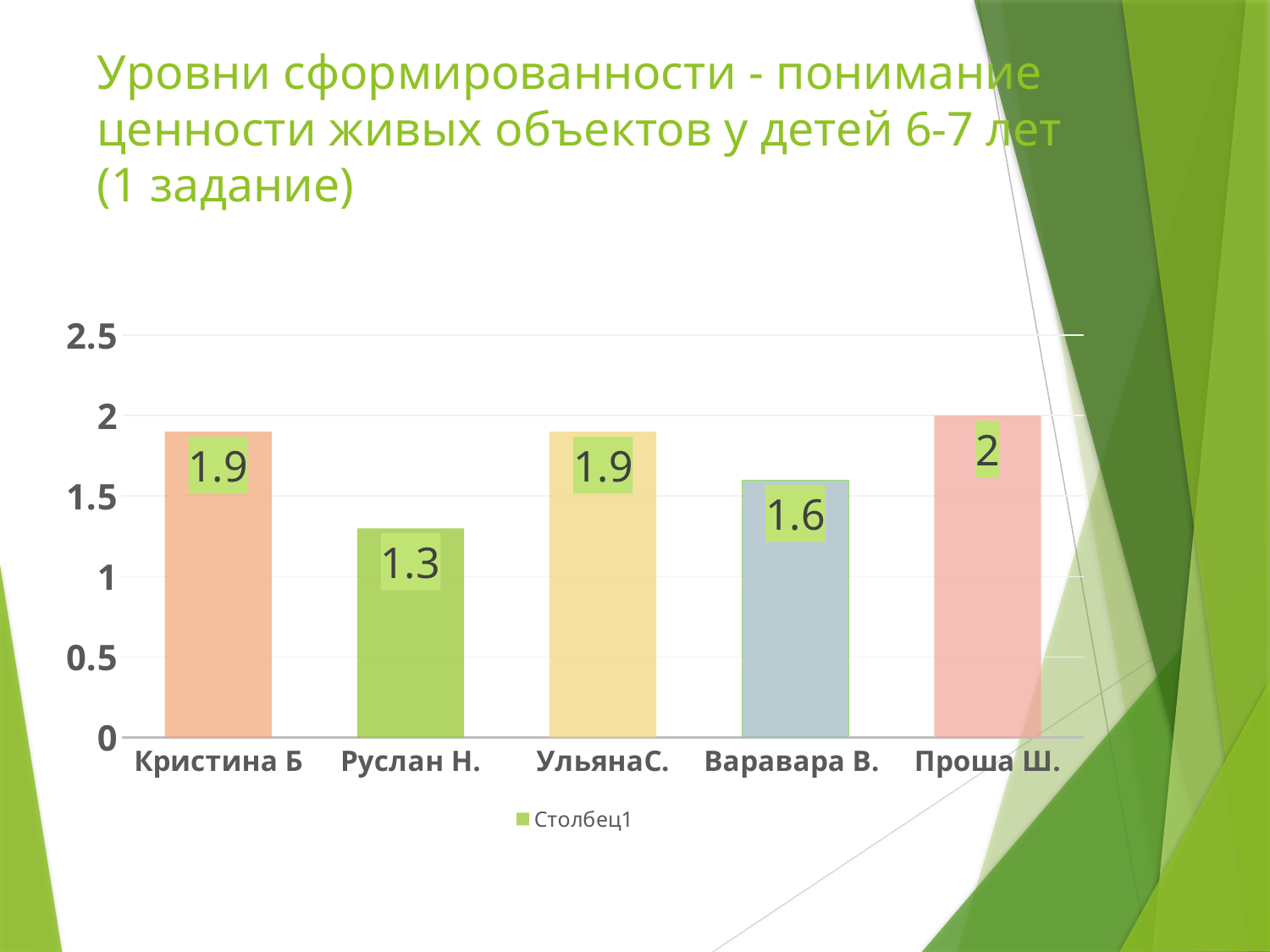
What kind of chart is shown on the slide? bar chart Which category has the lowest value? Руслан Н. How many categories are shown on the x axis? 5 What is the difference between the values for Проша Ш. and Руслан Н.? 0.7 Which is larger, the value for Варавара В. or the value for Руслан Н.? Варавара В. What is the value for Кристина Б? 1.9 What is the value for Варавара В.? 1.6 What is the value for Проша Ш.? 2 What is the difference between the values for УльянаС. and Варавара В.? 0.3 Which category has the highest value? Проша Ш. What is the legend entry shown below the chart? Столбец1 What is the value for Руслан Н.? 1.3